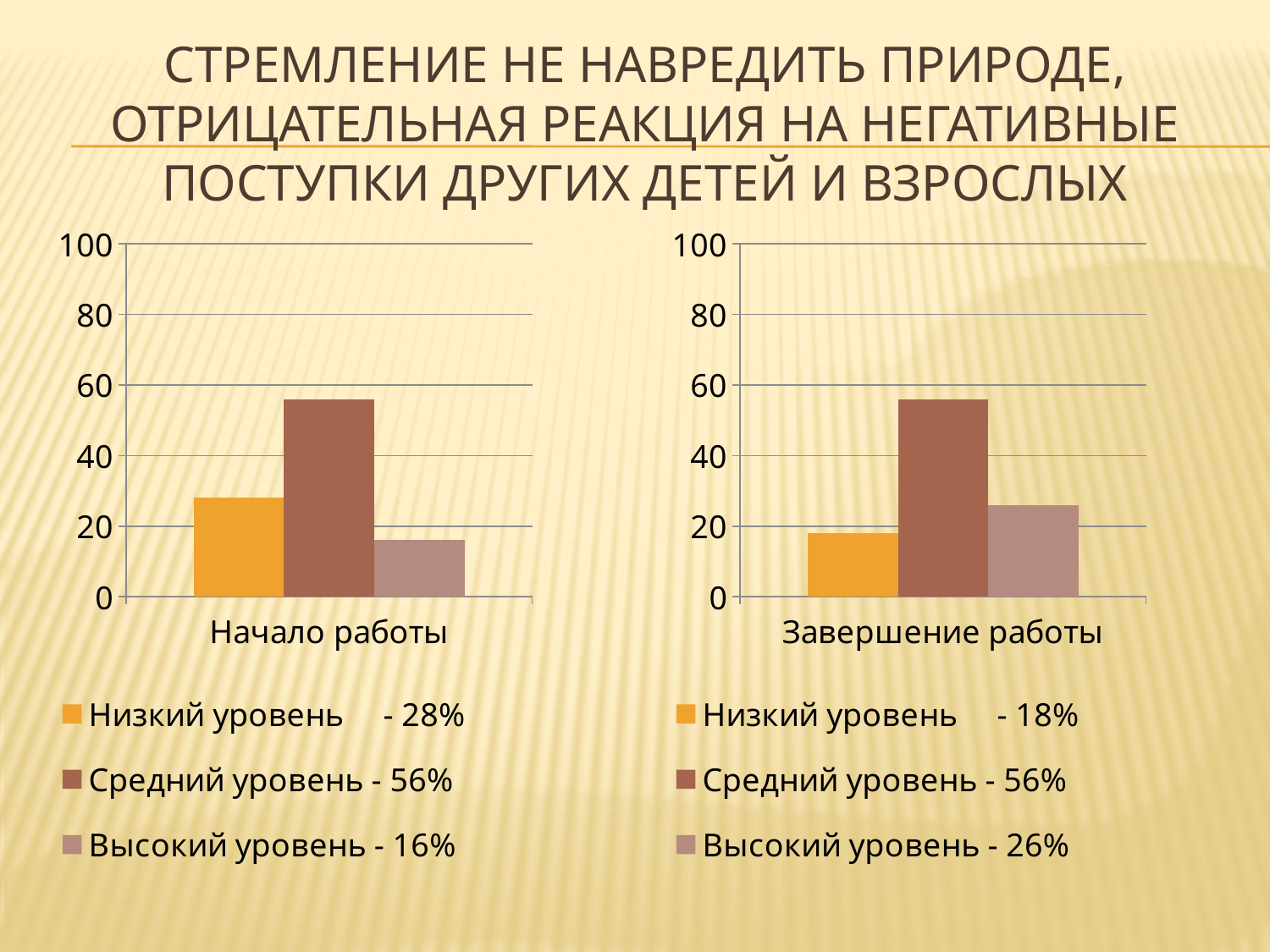
On the right chart (Завершение работы), is the value for Средний уровень greater or less than 40? greater What kind of chart is the right chart (Завершение работы)? bar chart On the right chart (Завершение работы), which level has the lowest value? Низкий уровень On the left chart (Начало работы), what is the value for Низкий уровень? 28% On the right chart (Завершение работы), what is the value for Высокий уровень? 26% What is the category label shown under the left chart? Начало работы On the left chart (Начало работы), which level has the highest value? Средний уровень On the right chart (Завершение работы), what is the difference between Высокий уровень and Низкий уровень? 8% On the left chart (Начало работы), which is larger: Низкий уровень or Высокий уровень? Низкий уровень On the left chart (Начало работы), what is the difference between Средний уровень and Высокий уровень? 40% How many series does the legend of the left chart (Начало работы) list? 3 On the right chart (Завершение работы), what colour is the bar for Низкий уровень? orange